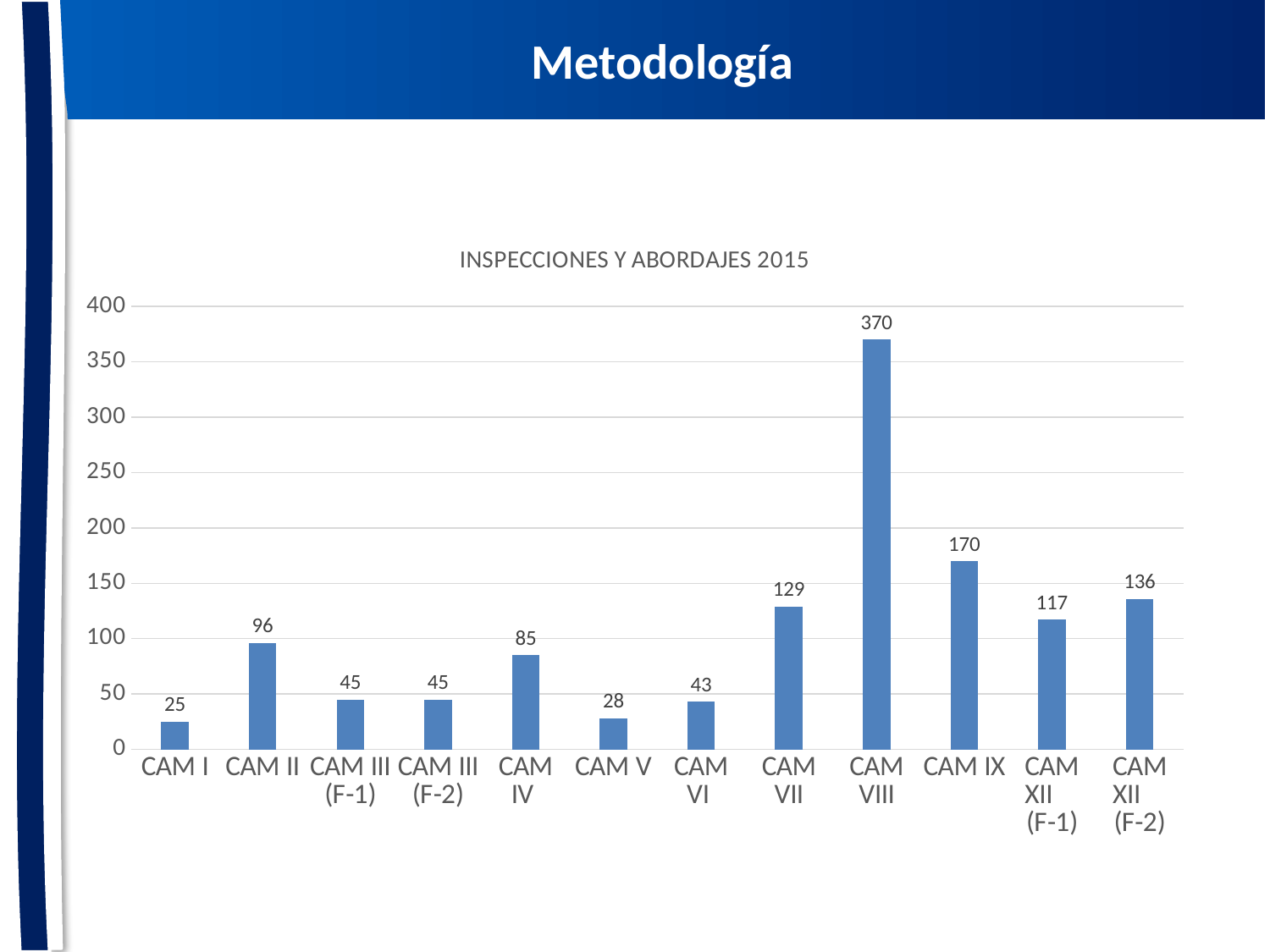
What is the value for CAM VIII? 370 What is the difference between the values for CAM XII (F-2) and CAM XII (F-1)? 19 How many categories are shown on the x axis? 12 Which category has the lowest value? CAM I Is the value for CAM VII greater or less than 100? greater What is the value for CAM IV? 85 Which is larger, the value for CAM II or the value for CAM VI? CAM II What is the title of the chart? INSPECCIONES Y ABORDAJES 2015 Which category has the highest value? CAM VIII What is the value for CAM XII (F-1)? 117 What kind of chart is shown on the slide? bar chart What is the difference between the values for CAM VIII and CAM IX? 200